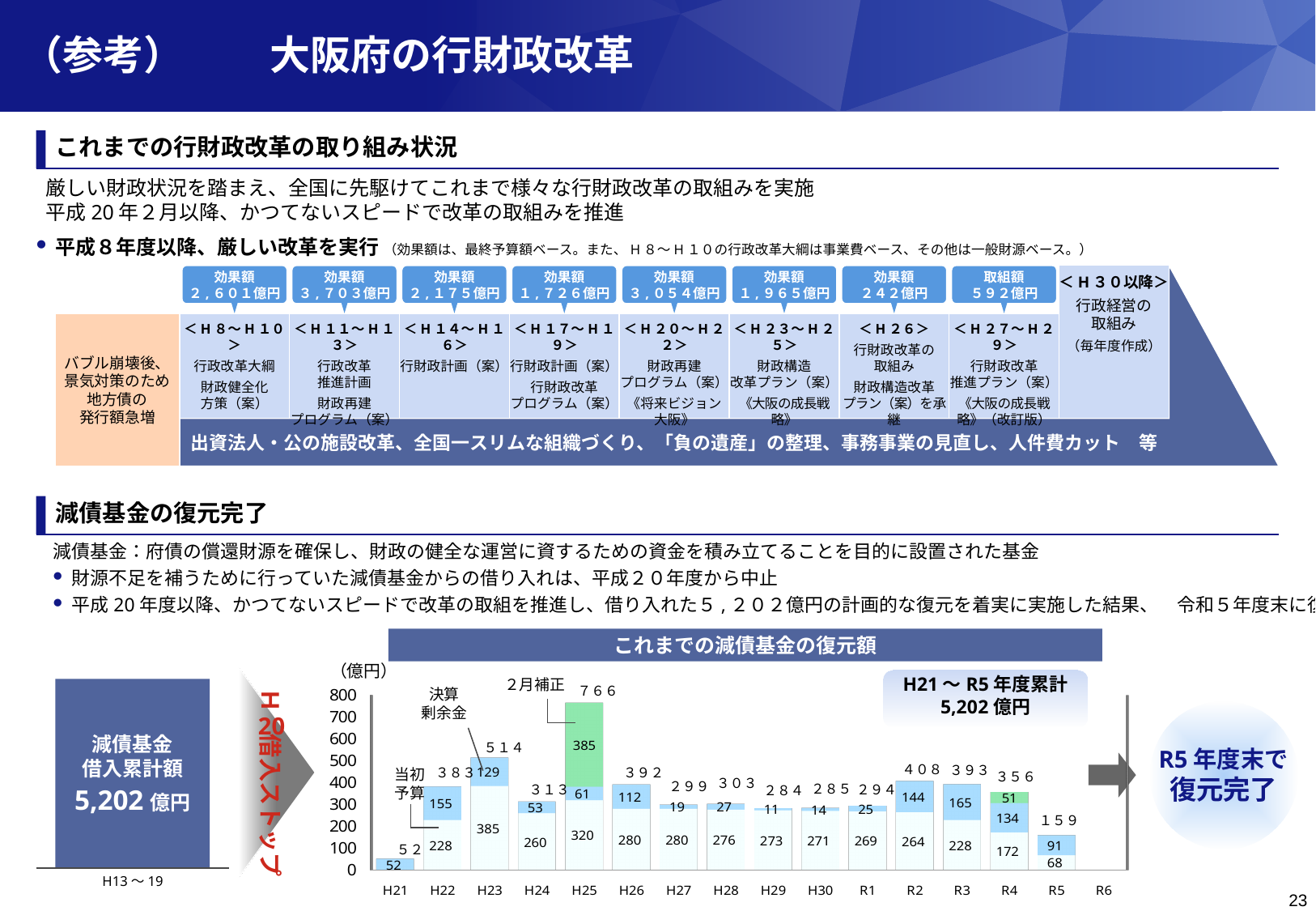
What unit is shown on the vertical axis of the これまでの減債基金の復元額 chart? 億円 In the これまでの減債基金の復元額 chart, what is the 2月補正 segment value for H25? 385 In the これまでの減債基金の復元額 chart, is the total value for R5 greater or less than 200? less In the これまでの減債基金の復元額 chart, what is the difference between the total for H25 and the total for H23? 252 In the これまでの減債基金の復元額 chart, what is the 決算剰余金 segment value for R2? 144 In the これまでの減債基金の復元額 chart, which is larger, the total for H22 or the total for H26? H26 In the これまでの減債基金の復元額 chart, what is the total value labelled for H30? 285 What kind of chart is shown under the title これまでの減債基金の復元額? Stacked bar chart In the これまでの減債基金の復元額 chart, do the total values rise or fall from H21 to H23? rise In the これまでの減債基金の復元額 chart, what is the total value labelled for H25? 766 In the これまでの減債基金の復元額 chart, which year has the highest total value? H25 In the これまでの減債基金の復元額 chart, which year has the lowest total value? H21